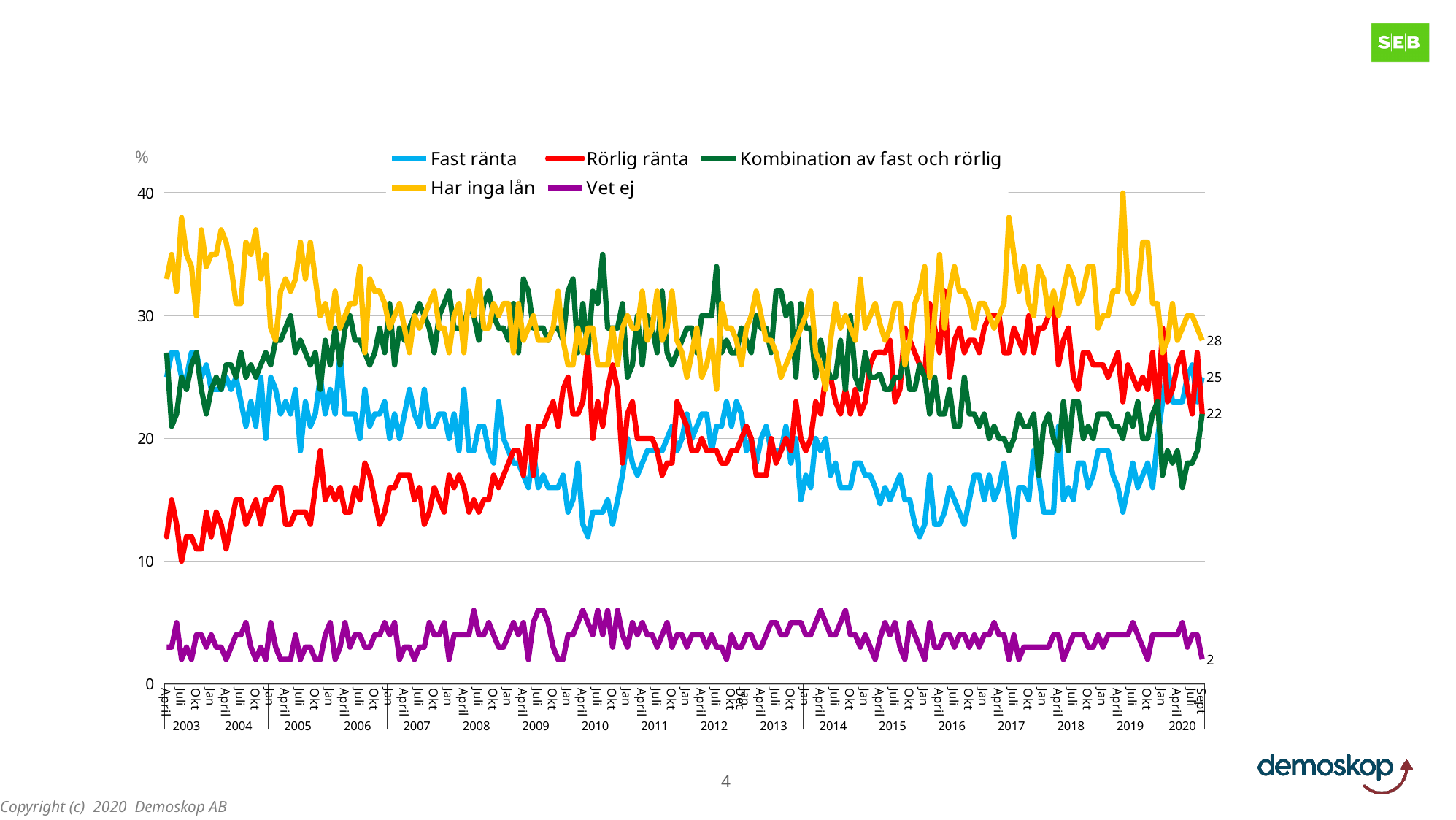
What kind of chart is shown on the slide? line chart What is the final value (Sept 2020) for Har inga lån? 28 Which series has the highest value at the end of the chart (Sept 2020)? Har inga lån What unit is shown on the vertical axis? % What is the difference between the final values of Har inga lån and Vet ej? 26 Is the value for Har inga lån in April 2003 greater or less than 30? greater What is the final value (Sept 2020) for Fast ränta? 25 Does the Rörlig ränta series generally rise or fall from 2003 to 2020? rise What is the final value (Sept 2020) for Vet ej? 2 Is the value for Vet ej in 2010 greater or less than 10? less How many series does the legend list? 5 Which series has the lowest values throughout the whole period? Vet ej